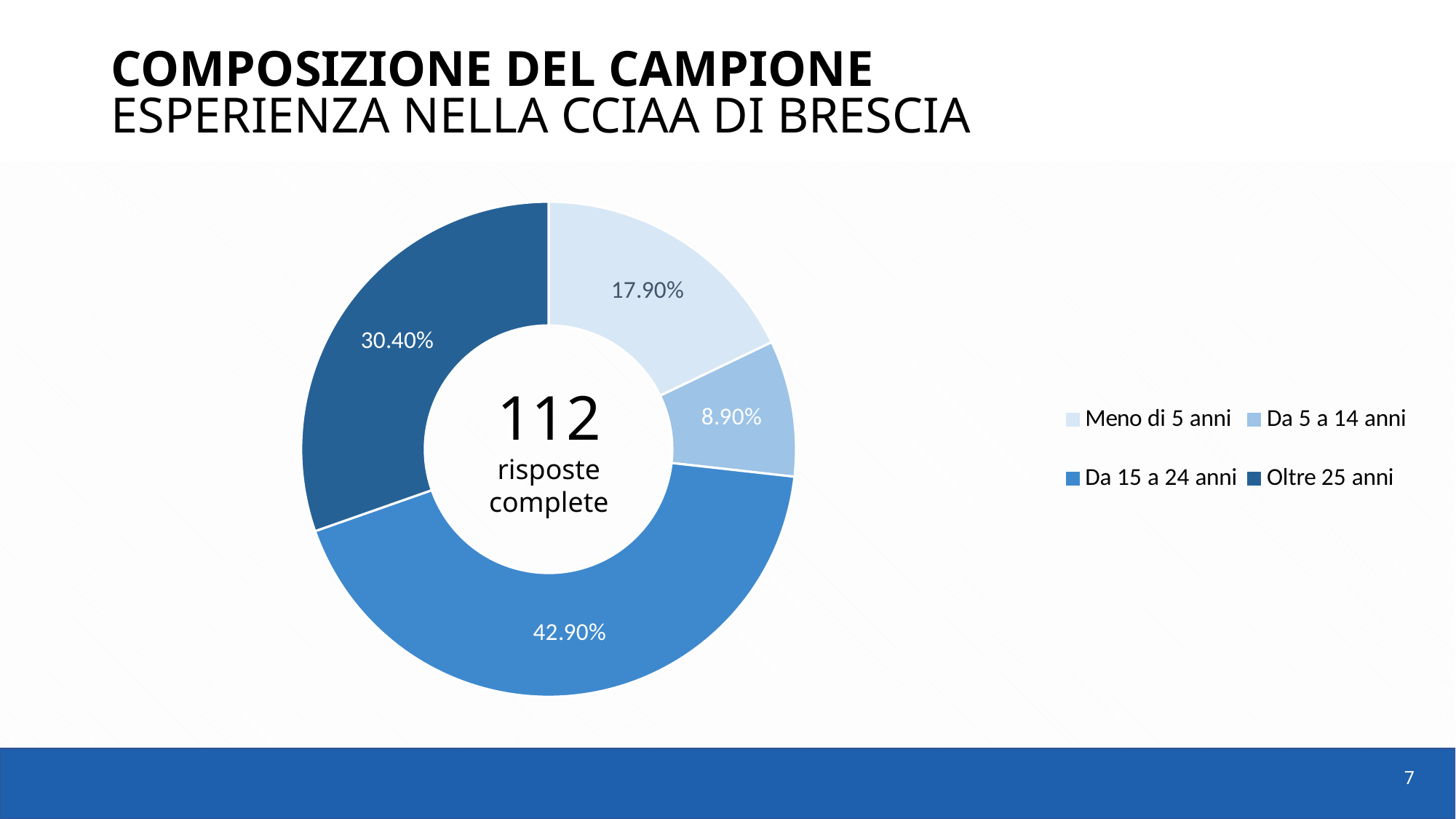
What kind of chart is shown on the slide? Doughnut (pie) chart What text appears below the number in the centre of the chart? risposte complete What percentage is shown for 'Meno di 5 anni'? 17.90% What is the difference in percentage points between 'Da 15 a 24 anni' and 'Oltre 25 anni'? 12.50% What percentage is shown for 'Da 15 a 24 anni'? 42.90% Which is larger: the share for 'Meno di 5 anni' or the share for 'Da 5 a 14 anni'? Meno di 5 anni Which category has the largest share of the chart? Da 15 a 24 anni What number is shown in the centre of the doughnut chart? 112 Which category has the smallest share of the chart? Da 5 a 14 anni How many categories does the legend list? 4 What percentage is shown for 'Da 5 a 14 anni'? 8.90% What percentage is shown for 'Oltre 25 anni'? 30.40%